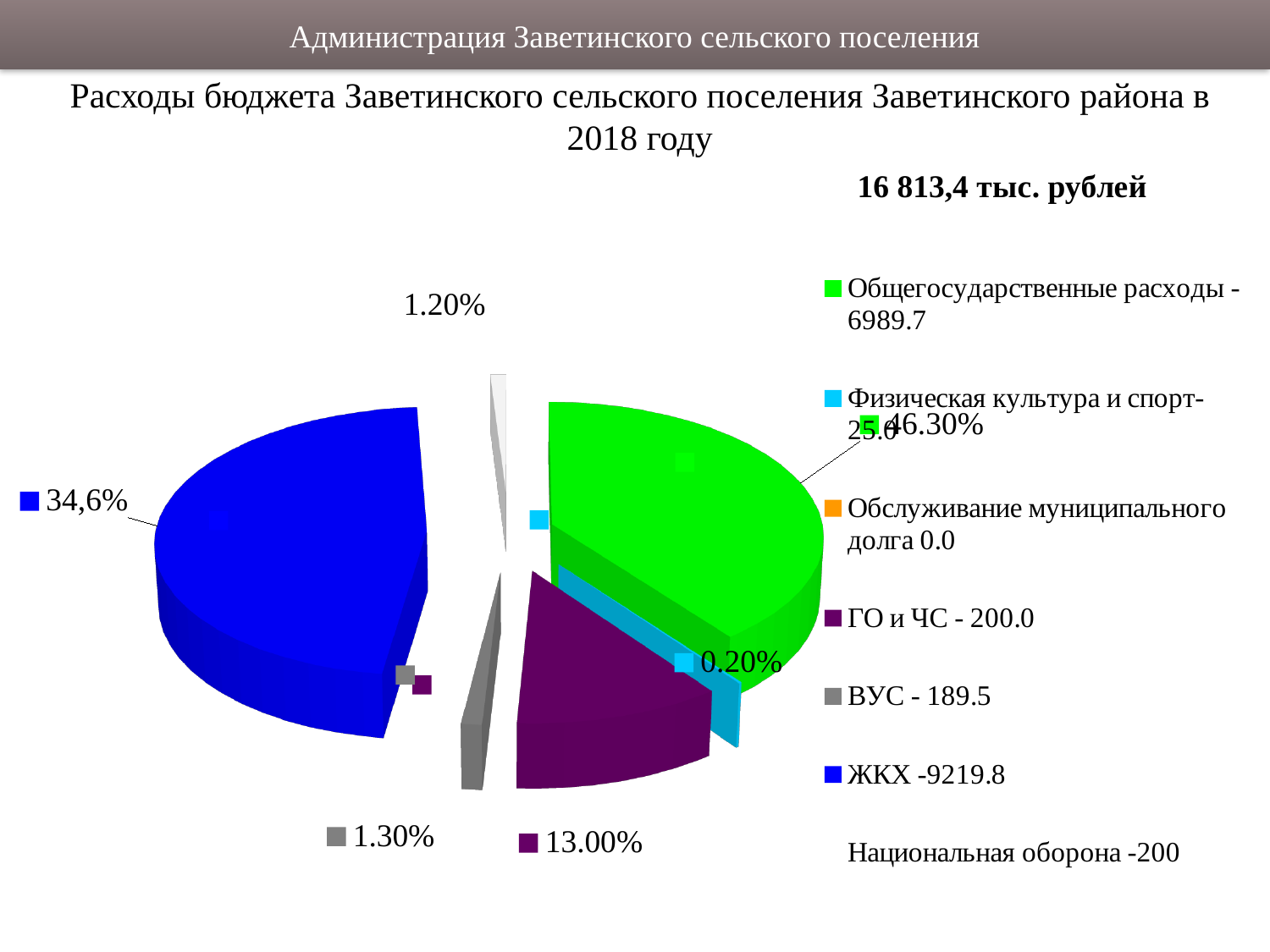
What percentage label is shown on the gray slice (ВУС)? 1.30% What percentage label is shown on the purple slice (ГО и ЧС)? 13.00% What value does the legend give for Обслуживание муниципального долга? 0.0 What total amount is stated above the chart? 16 813,4 тыс. рублей What percentage label is shown on the cyan slice (Физическая культура и спорт)? 0.20% Which slice is larger, ГО и ЧС or ВУС? ГО и ЧС What percentage label is shown on the blue slice (ЖКХ)? 34,6% Which labelled slice has the smallest share of the pie? Физическая культура и спорт What value does the legend give for ЖКХ? 9219.8 Which slice has the largest share of the pie? ЖКХ What kind of chart is shown on the slide? pie chart What percentage label is shown on the green slice (Общегосударственные расходы)? 46.30%